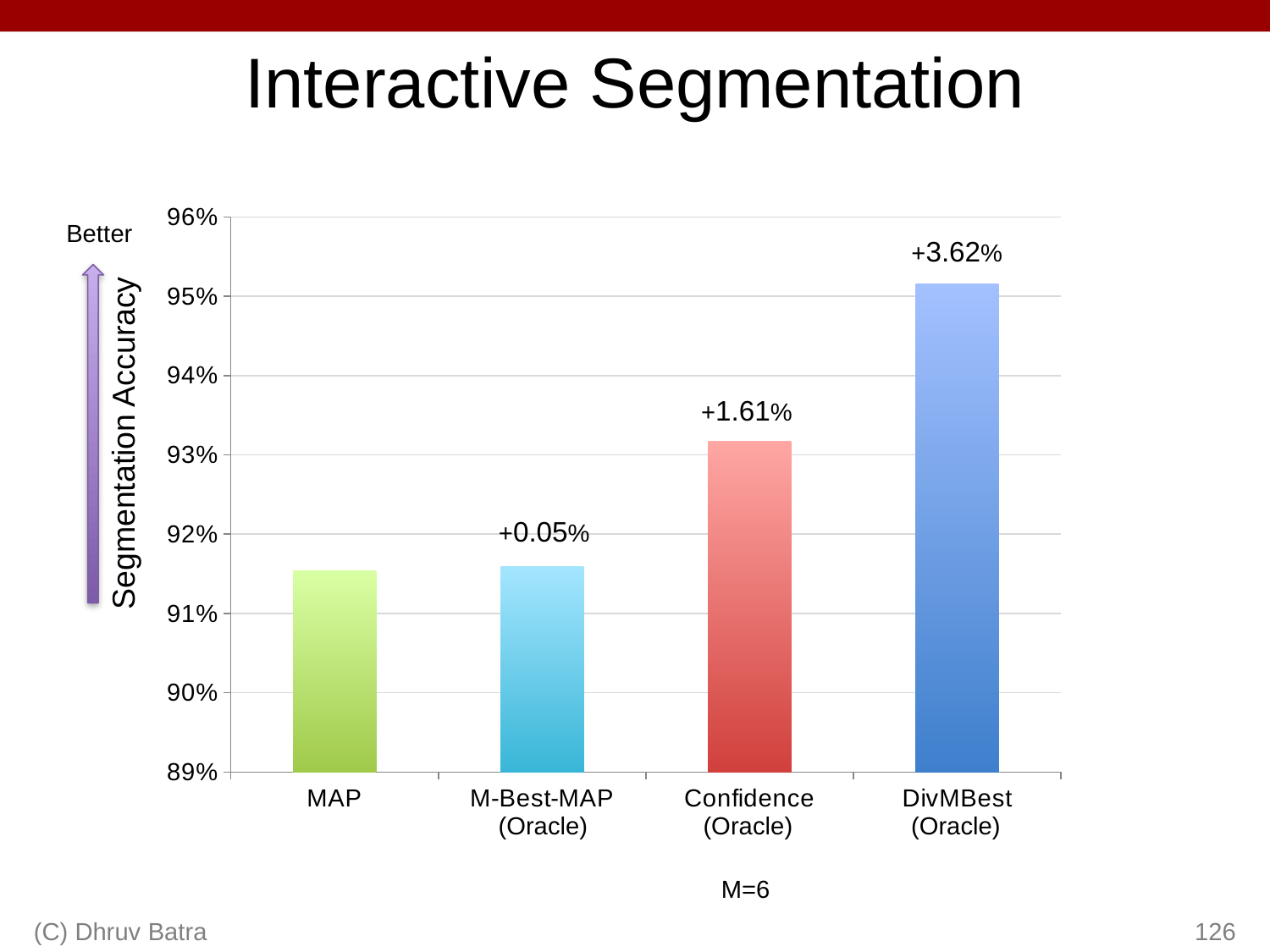
What is the label on the vertical axis of the chart? Segmentation Accuracy What improvement label is printed above the M-Best-MAP (Oracle) bar? +0.05% Is the value for MAP greater or less than 91%? greater What improvement label is printed above the Confidence (Oracle) bar? +1.61% Do the bar values rise or fall from left to right across the categories? rise Which is larger, the value for Confidence (Oracle) or the value for DivMBest (Oracle)? DivMBest (Oracle) Which category has the highest segmentation accuracy? DivMBest (Oracle) What improvement label is printed above the DivMBest (Oracle) bar? +3.62% Is the value for Confidence (Oracle) greater or less than 94%? less Is the value for DivMBest (Oracle) greater or less than 94%? greater How many categories (bars) are plotted in the chart? 4 What kind of chart is shown on the slide? bar chart